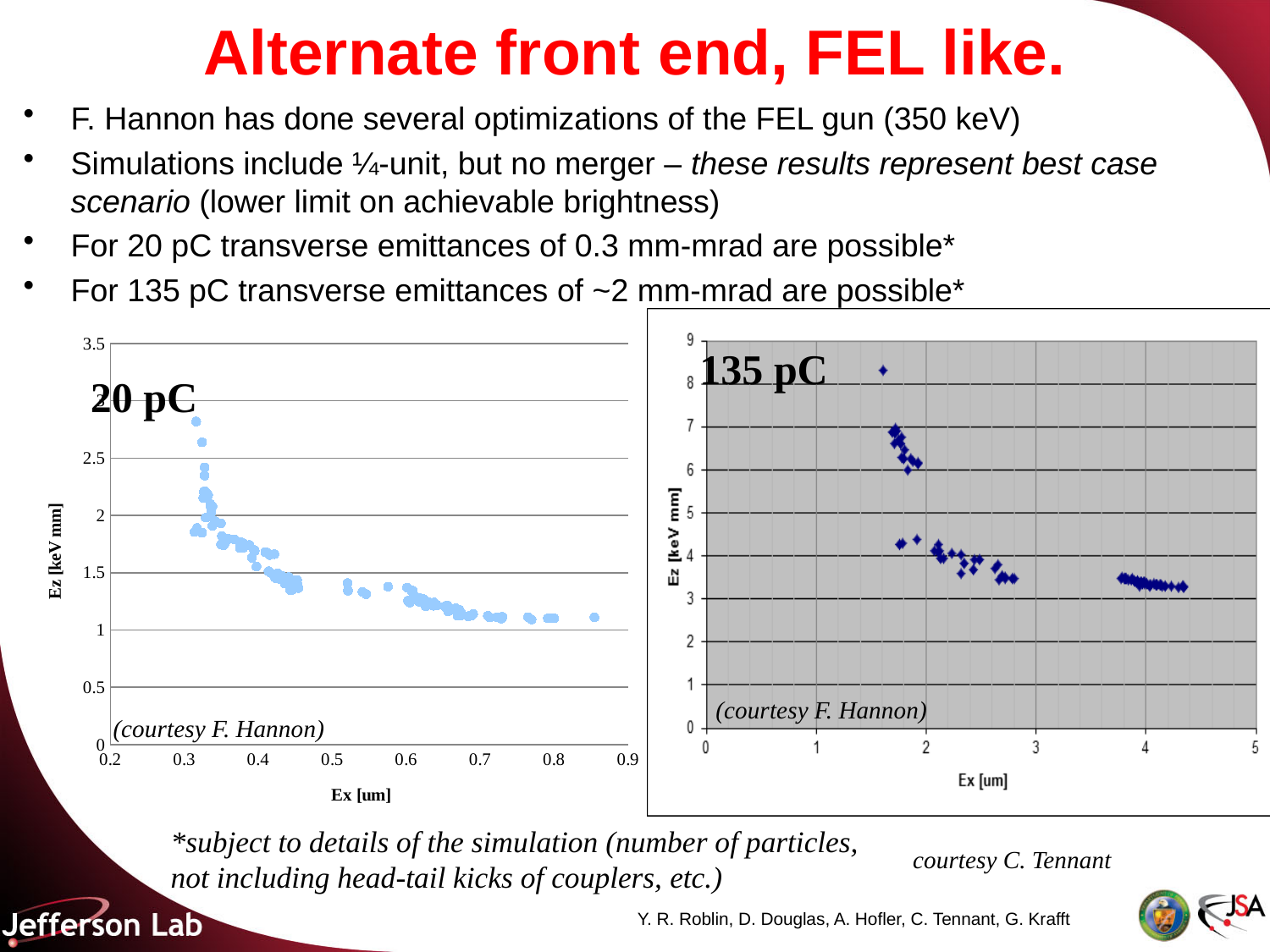
In the 135 pC chart, which has the larger Ez value: the points near Ex = 2 or the points near Ex = 4? the points near Ex = 2 In the 20 pC chart, are the Ez values of the points near Ex = 0.8 greater or less than 1.5? less In the 135 pC chart, do the Ez values rise or fall as Ex increases? fall In the 20 pC chart, which has the larger Ez value: the points near Ex = 0.3 or the points near Ex = 0.8? the points near Ex = 0.3 What kind of chart is the 20 pC chart on the left? scatter chart In the 135 pC chart, are the Ez values of the points near Ex = 4 greater or less than 4? less What is the y-axis label of the 135 pC chart? Ez [keV mm] In the 20 pC chart, is the highest plotted Ez value greater or less than 2.5? greater In the 20 pC chart, do the Ez values rise or fall as Ex increases? fall What is the x-axis label of the 20 pC chart? Ex [um] What kind of chart is the 135 pC chart on the right? scatter chart